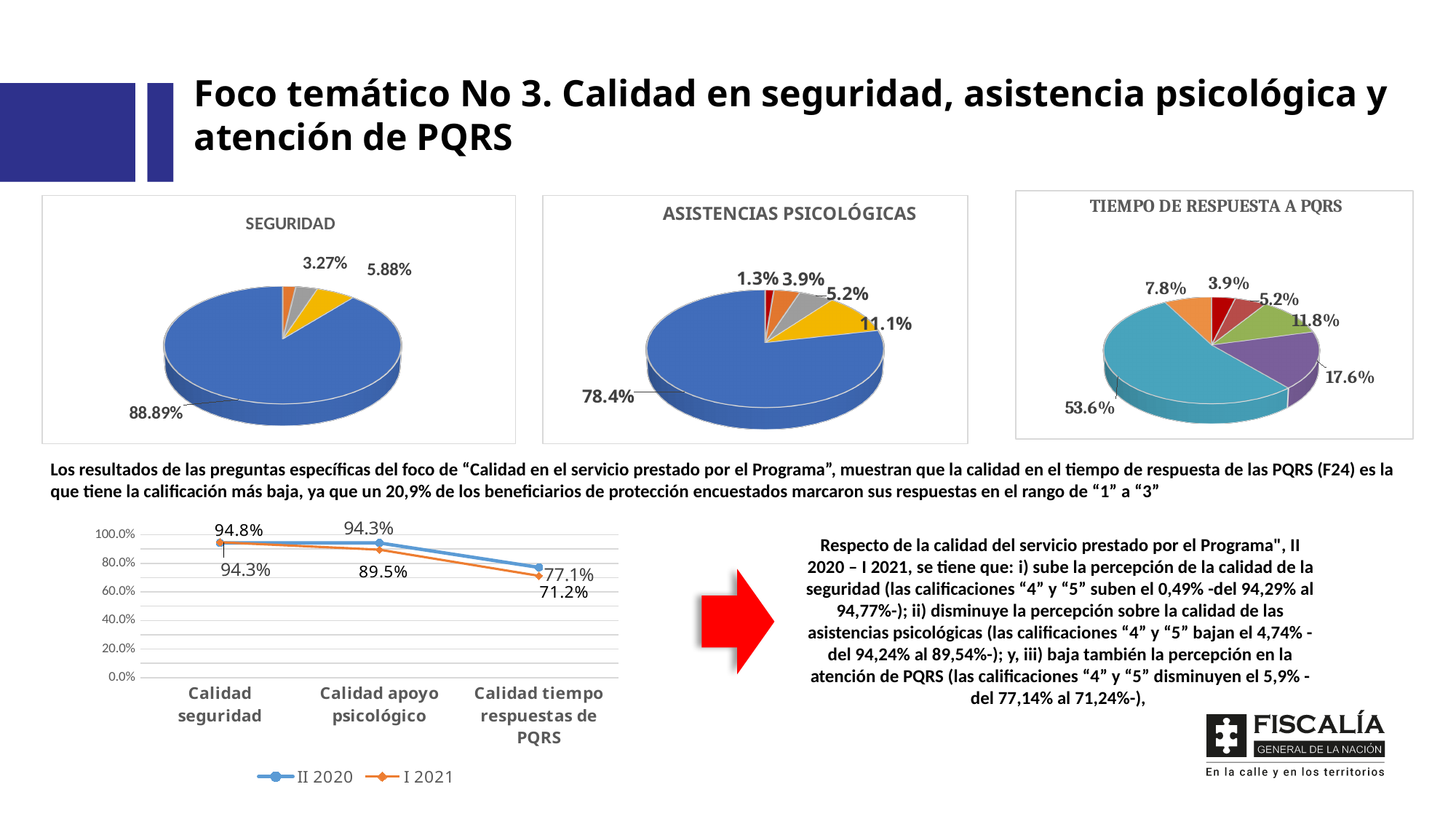
How many slices does the TIEMPO DE RESPUESTA A PQRS pie chart have? 6 In the TIEMPO DE RESPUESTA A PQRS pie chart, what is the value of the largest slice? 53.6% In the SEGURIDAD pie chart, what is the value of the largest slice? 88.89% How many series does the legend of the line chart at the bottom left list? 2 In the ASISTENCIAS PSICOLÓGICAS pie chart, what is the value of the smallest slice? 1.3% In the line chart at the bottom left, what is the II 2020 value for Calidad seguridad? 94.3% In the ASISTENCIAS PSICOLÓGICAS pie chart, what is the value of the largest slice? 78.4% What kind of chart is the SEGURIDAD chart? Pie chart How many categories are shown on the x axis of the line chart at the bottom left? 3 In the line chart at the bottom left, what is the I 2021 value for Calidad tiempo respuestas de PQRS? 71.2% In the line chart at the bottom left, do the I 2021 values rise or fall from Calidad seguridad to Calidad tiempo respuestas de PQRS? Fall In the line chart at the bottom left, what is the difference between the II 2020 and I 2021 values for Calidad apoyo psicológico? 4.8 percentage points